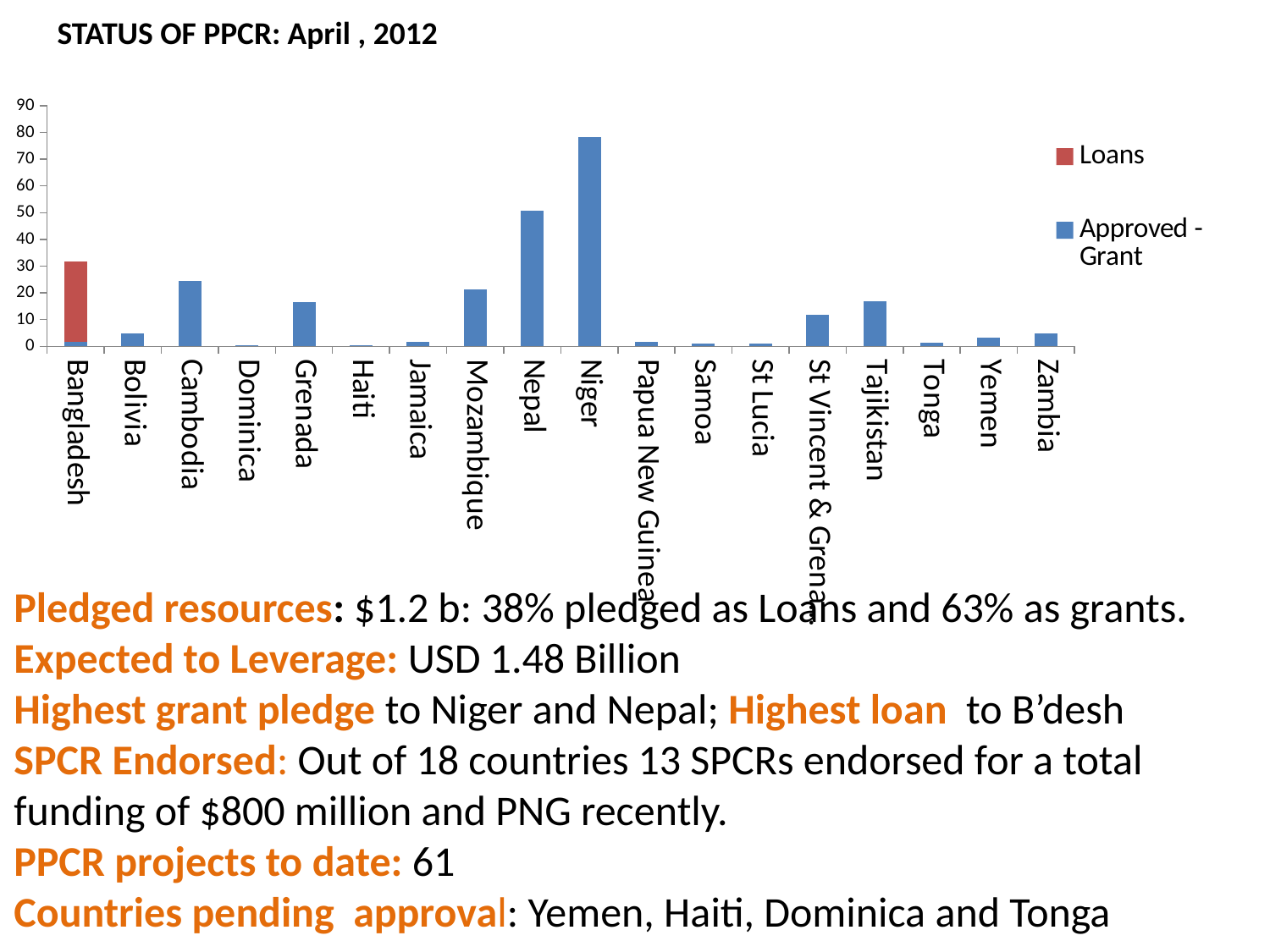
What kind of chart is shown on the slide? bar chart Which country has the tallest bar in the chart? Niger Which has the larger bar, Niger or Nepal? Niger Is the value for Bolivia greater or less than 10? less Is the value for Nepal greater or less than 40? greater How many countries are shown on the x axis of the chart? 18 Is the value for Tajikistan greater or less than 20? less How many series does the chart legend list? 2 Which country is the only one with a visible Loans (red) segment in its bar? Bangladesh Which has the larger bar, Cambodia or Grenada? Cambodia